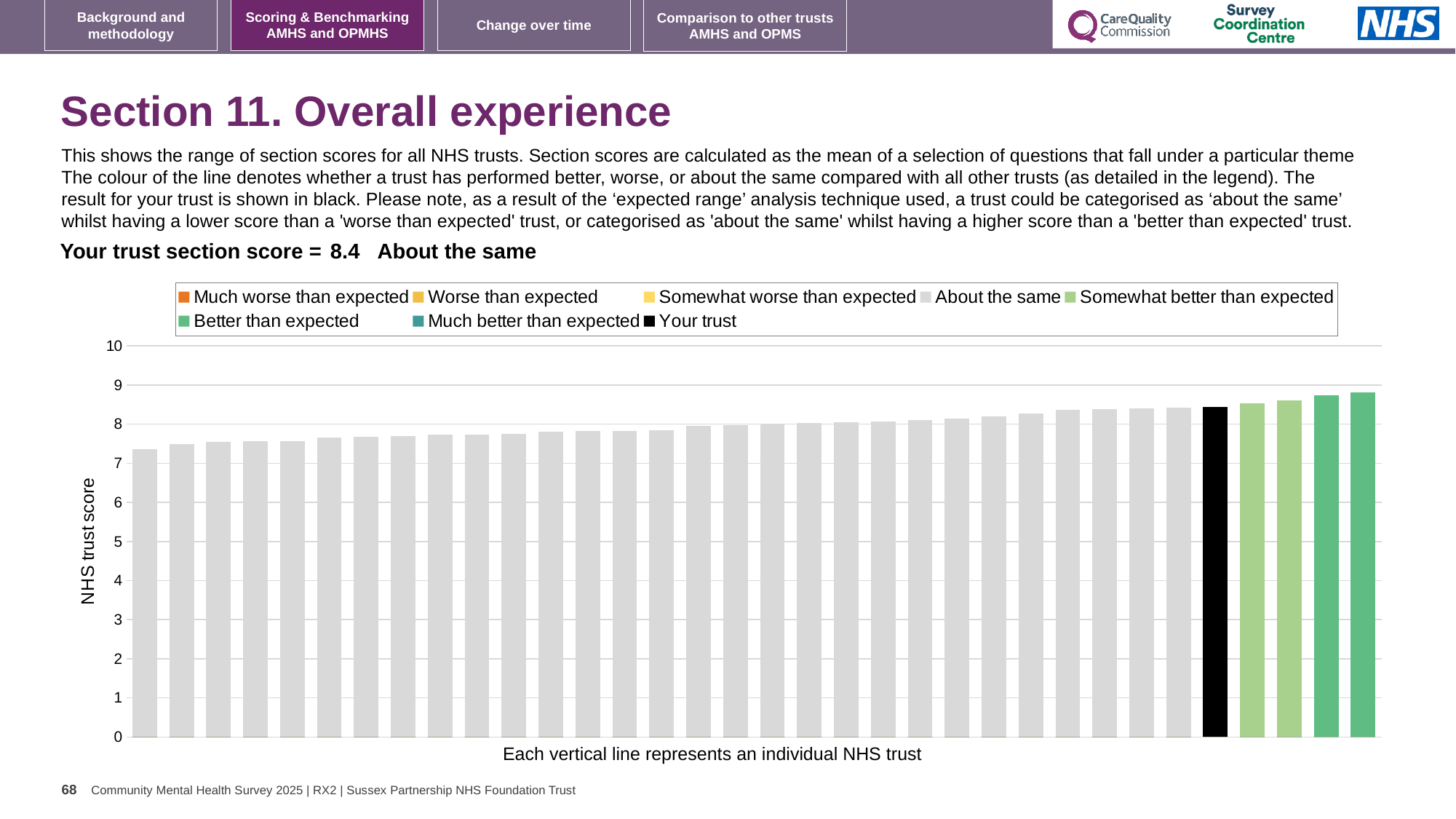
How many bars are coloured as 'Better than expected' (darker green)? 2 What is the section score for your trust shown on the slide? 8.4 Is the value for your trust (the black bar) greater or less than 8? greater How many entries does the chart legend list? 8 Is the value for the leftmost (lowest) bar greater or less than 8? less Which is higher: the black 'Your trust' bar or the rightmost bar? The rightmost bar Which benchmarking category is your trust placed in for Section 11? About the same Is the value for the rightmost (highest) bar greater or less than 9? less How many bars are coloured as 'Somewhat better than expected' (light green)? 2 What kind of chart is shown on the slide? Bar chart Do the trust scores rise or fall moving from left to right along the x axis? Rise What is the label on the vertical axis of the chart? NHS trust score